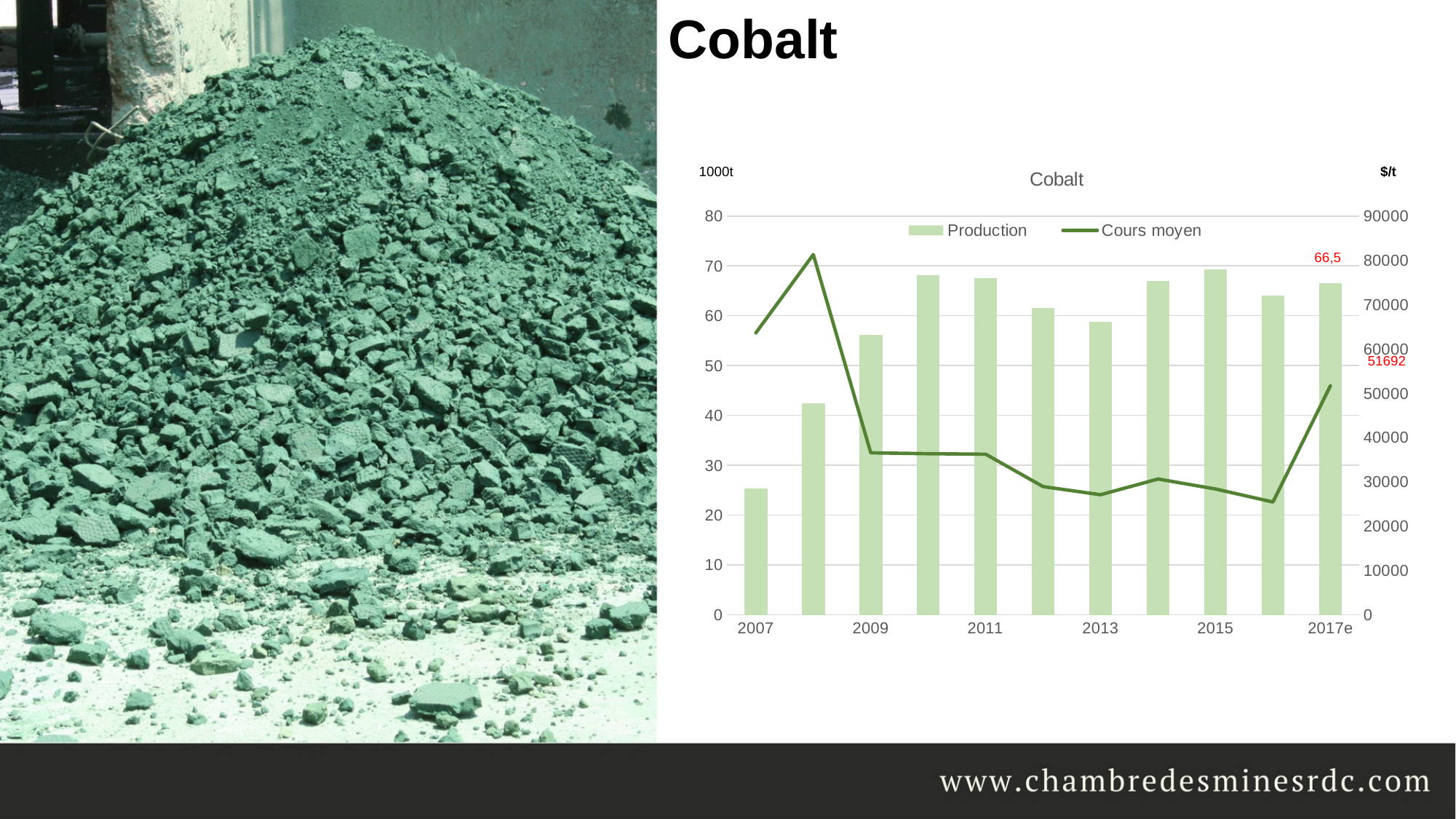
What kind of chart is this? Combined bar and line chart What is the Cours moyen value labelled for 2017e? 51692 In which year does the Cours moyen line reach its highest point? 2008 Which year has the larger Production bar, 2008 or 2009? 2009 How many years (bars) are shown on the x axis? 11 Is the Cours moyen value for 2016 greater or less than 30000? less Is the Production value for 2007 greater or less than 30? less Which year has the higher Cours moyen, 2007 or 2009? 2007 How many series does the legend list? 2 Which year has the lowest Production bar? 2007 What is the Production value labelled for 2017e? 66,5 Is the Cours moyen value for 2008 greater or less than 80000? greater